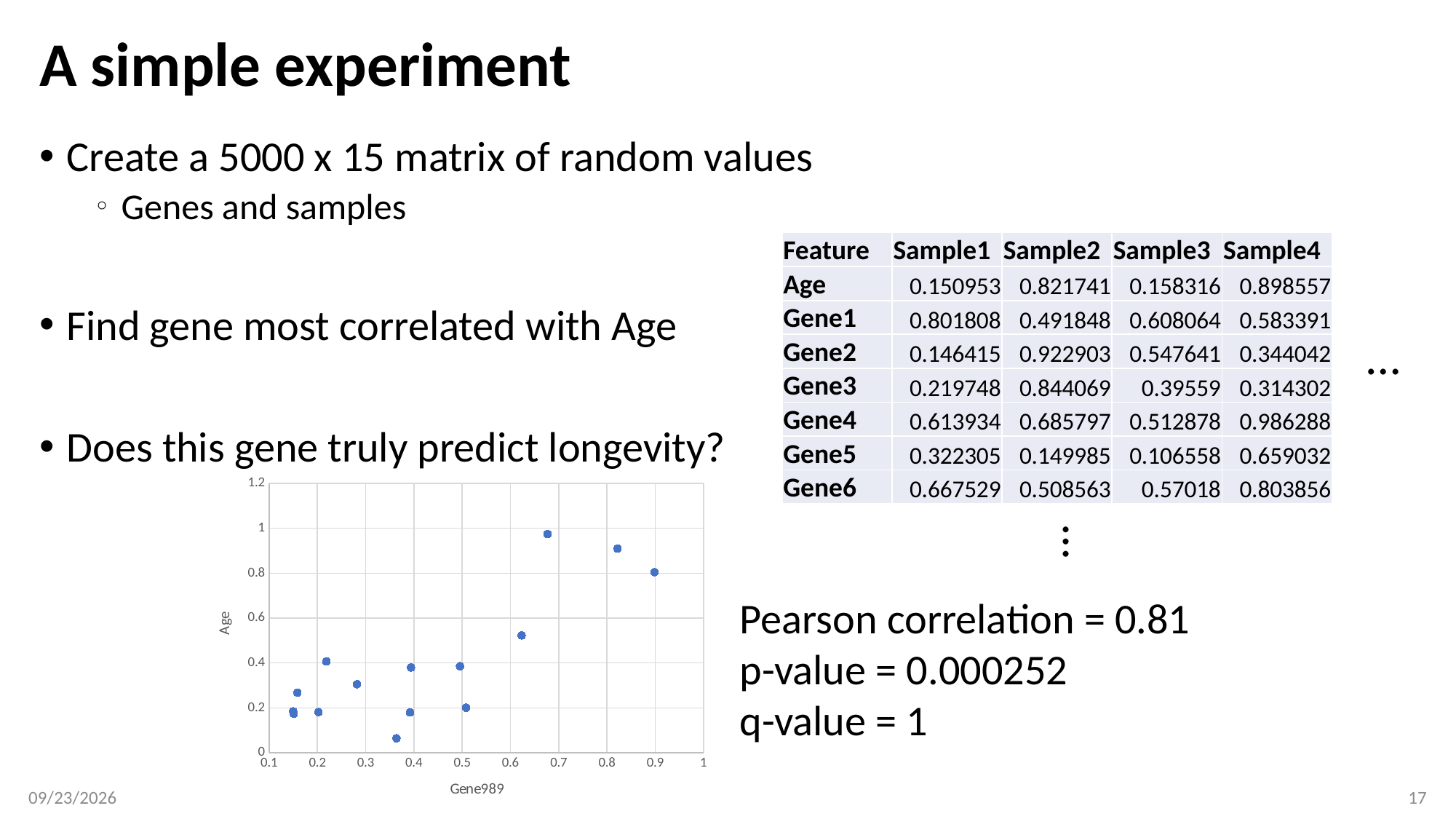
Do the Age values generally rise or fall as Gene989 increases along the x axis? rise Which has the higher Age value: the point at Gene989 of about 0.68 or the point at Gene989 of about 0.9? the point at about 0.68 What is the maximum value shown on the y axis of the scatter chart? 1.2 Is the Age value of the point at Gene989 of about 0.62 greater or less than 0.4? greater Is the Age value of the point with the largest Gene989 value (near 0.9) greater or less than 0.6? greater What is the label on the x axis of the scatter chart? Gene989 What is the maximum value shown on the x axis of the scatter chart? 1 Is the highest Age value plotted in the scatter chart greater or less than 0.8? greater What kind of chart is shown on the slide? scatter chart What is the label on the y axis of the scatter chart? Age